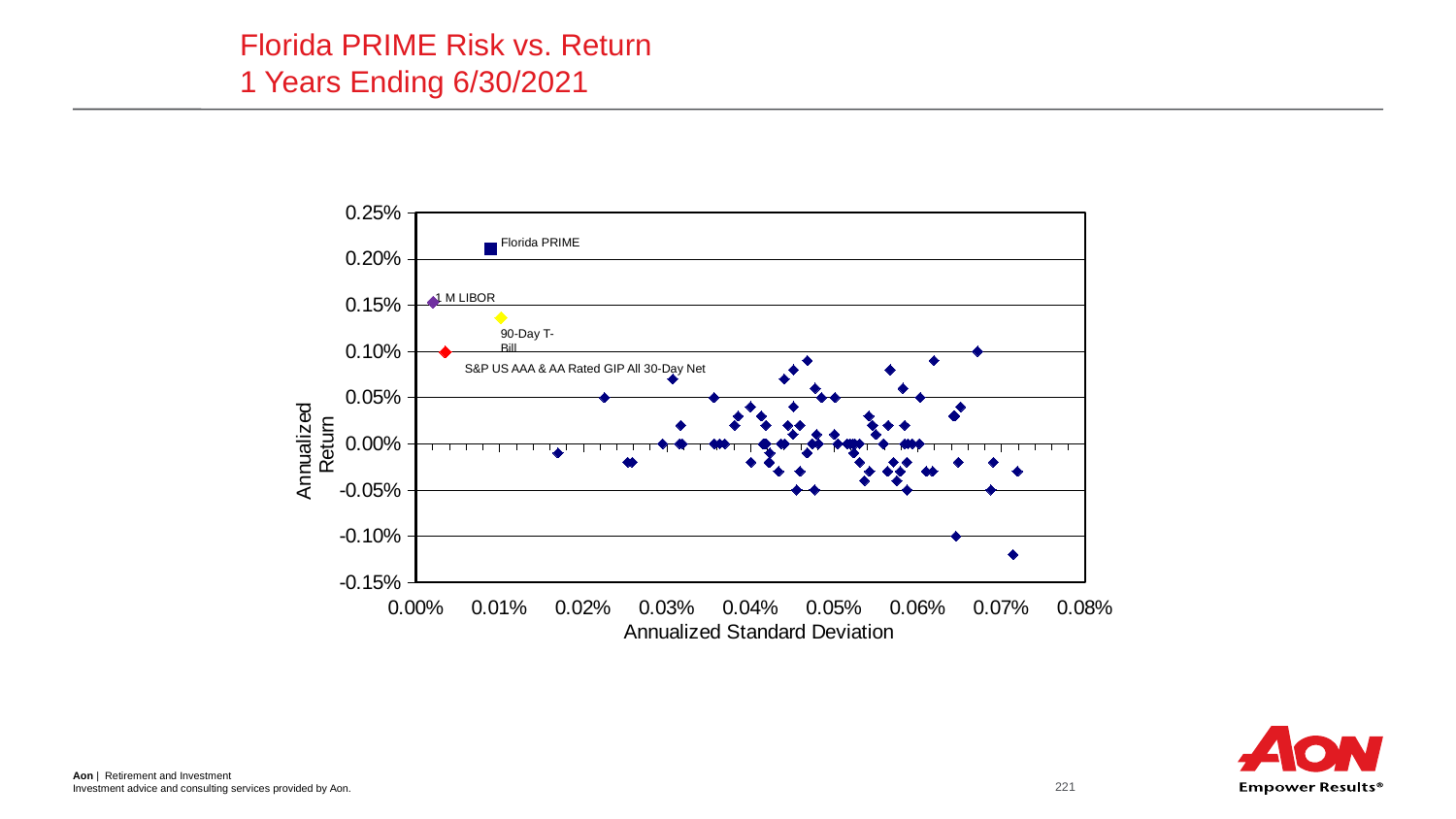
What kind of chart is shown on the slide? scatter chart Is the annualized standard deviation for Florida PRIME greater or less than 0.02%? less Is the annualized return for the 90-Day T-Bill greater or less than 0.10%? greater What is the title of the chart on the slide? Florida PRIME Risk vs. Return 1 Years Ending 6/30/2021 What is the label of the horizontal axis? Annualized Standard Deviation How many points on the chart are labeled by name? 4 Is the annualized return for Florida PRIME greater or less than 0.15%? greater Which has the higher annualized return, Florida PRIME or 1 M LIBOR? Florida PRIME Which labeled point has the lowest annualized return? S&P US AAA & AA Rated GIP All 30-Day Net Which labeled point has the highest annualized return? Florida PRIME Which has the higher annualized return, the 90-Day T-Bill or the S&P US AAA & AA Rated GIP All 30-Day Net? 90-Day T-Bill